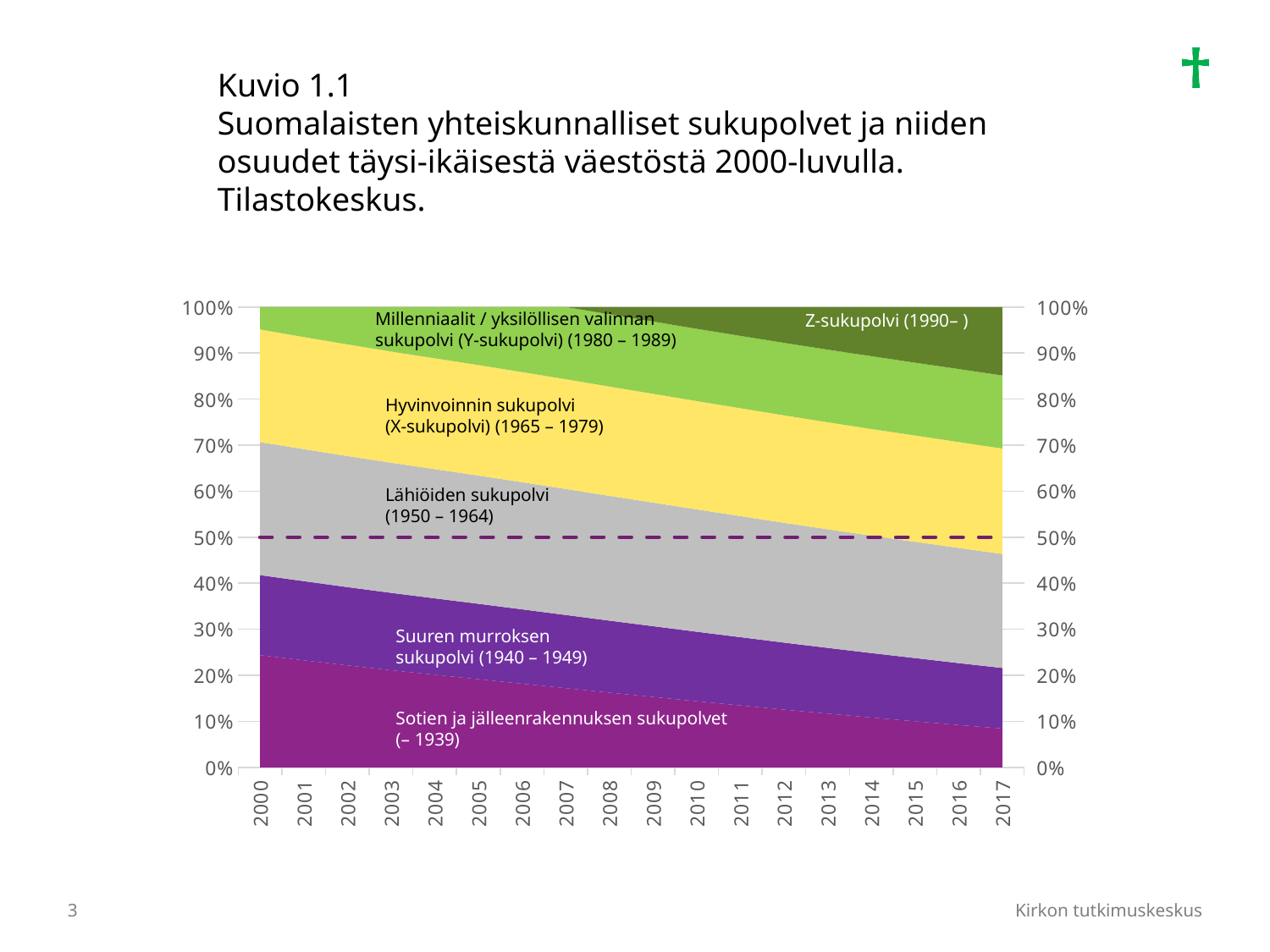
At what percentage level is the horizontal dashed line drawn across the chart? 50% How many generation groups are labelled in the chart? 6 How many years are shown along the x axis of the chart? 18 Is the share of 'Sotien ja jälleenrakennuksen sukupolvet (– 1939)' in 2000 greater or less than 20%? greater In 2000, which has the larger share: 'Sotien ja jälleenrakennuksen sukupolvet (– 1939)' or 'Suuren murroksen sukupolvi (1940 – 1949)'? Sotien ja jälleenrakennuksen sukupolvet (– 1939) What kind of chart is shown on the slide? Stacked area chart What is the first year shown on the x axis? 2000 In 2017, which has the larger share: 'Lähiöiden sukupolvi (1950 – 1964)' or 'Suuren murroksen sukupolvi (1940 – 1949)'? Lähiöiden sukupolvi (1950 – 1964) Does the share of 'Sotien ja jälleenrakennuksen sukupolvet (– 1939)' rise or fall from 2000 to 2017? Fall Is the share of 'Sotien ja jälleenrakennuksen sukupolvet (– 1939)' in 2017 greater or less than 20%? less What is the last year shown on the x axis? 2017 Does the share of 'Z-sukupolvi (1990– )' rise or fall over the years shown? Rise